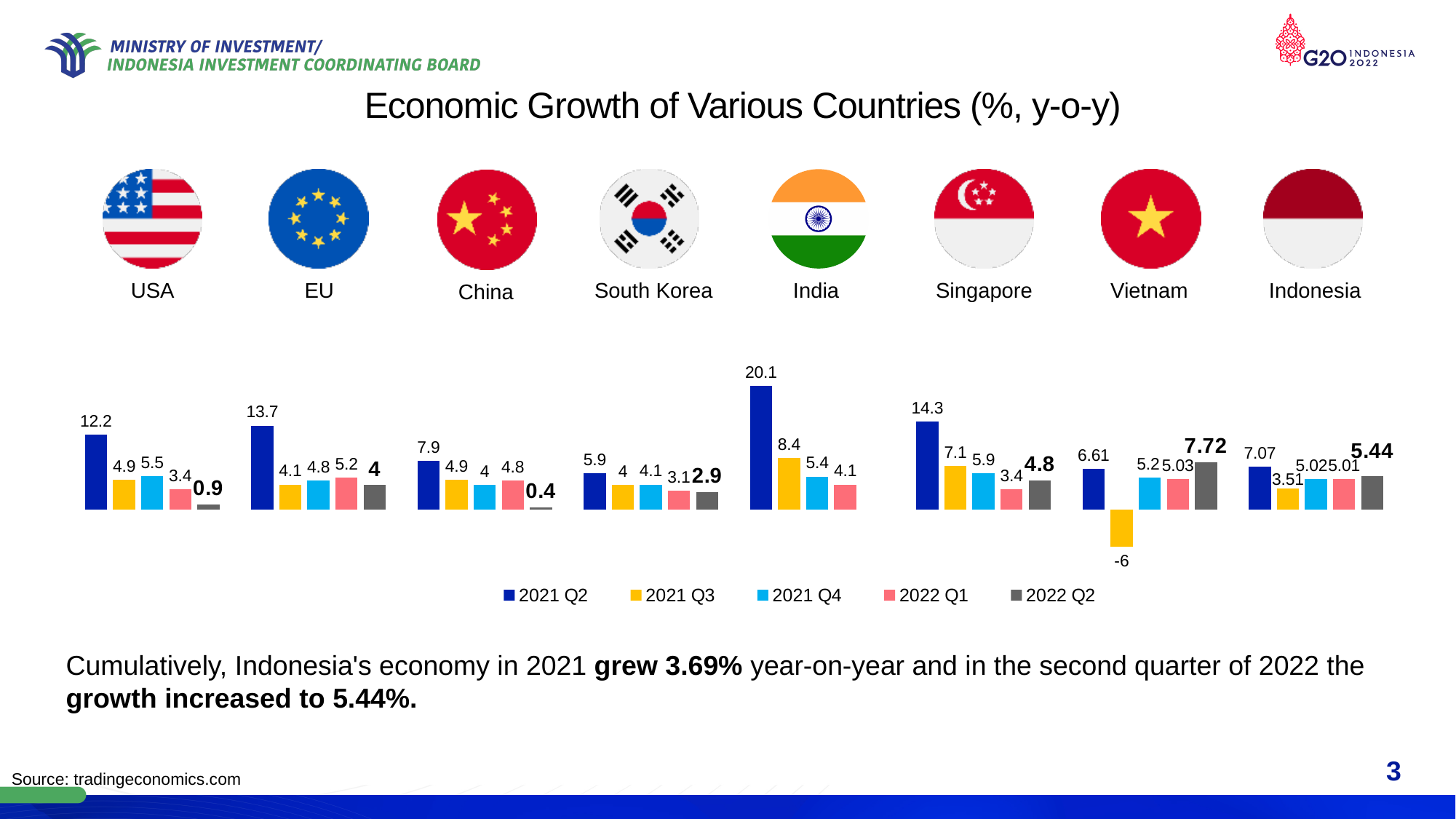
Which country has the lowest 2022 Q2 value? China What kind of chart is shown on the slide? Bar chart What is the difference between Vietnam's 2022 Q2 value and Indonesia's 2022 Q2 value? 2.28 Which country has the highest 2021 Q2 value? India What is the 2021 Q2 economic growth value for India? 20.1 What is the 2022 Q2 economic growth value for Indonesia? 5.44 Which series is shown in yellow in the legend? 2021 Q3 How many countries are shown in the chart? 8 Which is larger, the 2021 Q2 value for EU or the 2021 Q2 value for USA? EU How many series does the legend list? 5 What is the 2021 Q3 value for Vietnam? -6 What is the title of the chart? Economic Growth of Various Countries (%, y-o-y)